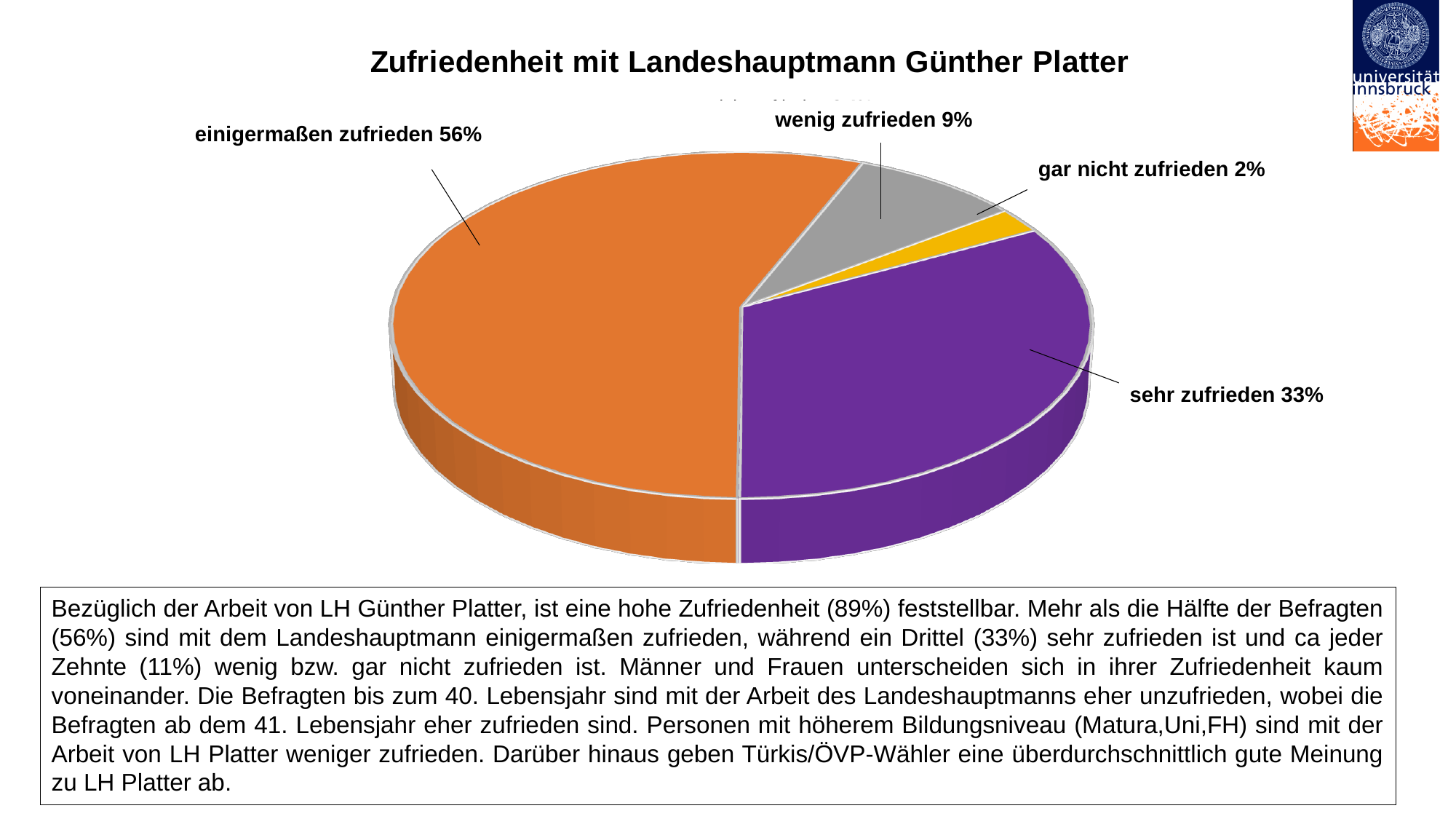
What share of the pie is labelled "sehr zufrieden"? 33% What share of the pie is labelled "gar nicht zufrieden"? 2% What is the difference in percentage points between "wenig zufrieden" and "gar nicht zufrieden"? 7 percentage points How many categories are shown in the pie chart? 4 What share of the pie is labelled "wenig zufrieden"? 9% Which category has the smallest slice of the pie? gar nicht zufrieden What kind of chart is shown on the slide? Pie chart Which is larger, the share for "sehr zufrieden" or the share for "wenig zufrieden"? sehr zufrieden Which category has the largest slice of the pie? einigermaßen zufrieden What is the title of the chart? Zufriedenheit mit Landeshauptmann Günther Platter What is the difference in percentage points between "einigermaßen zufrieden" and "sehr zufrieden"? 23 percentage points